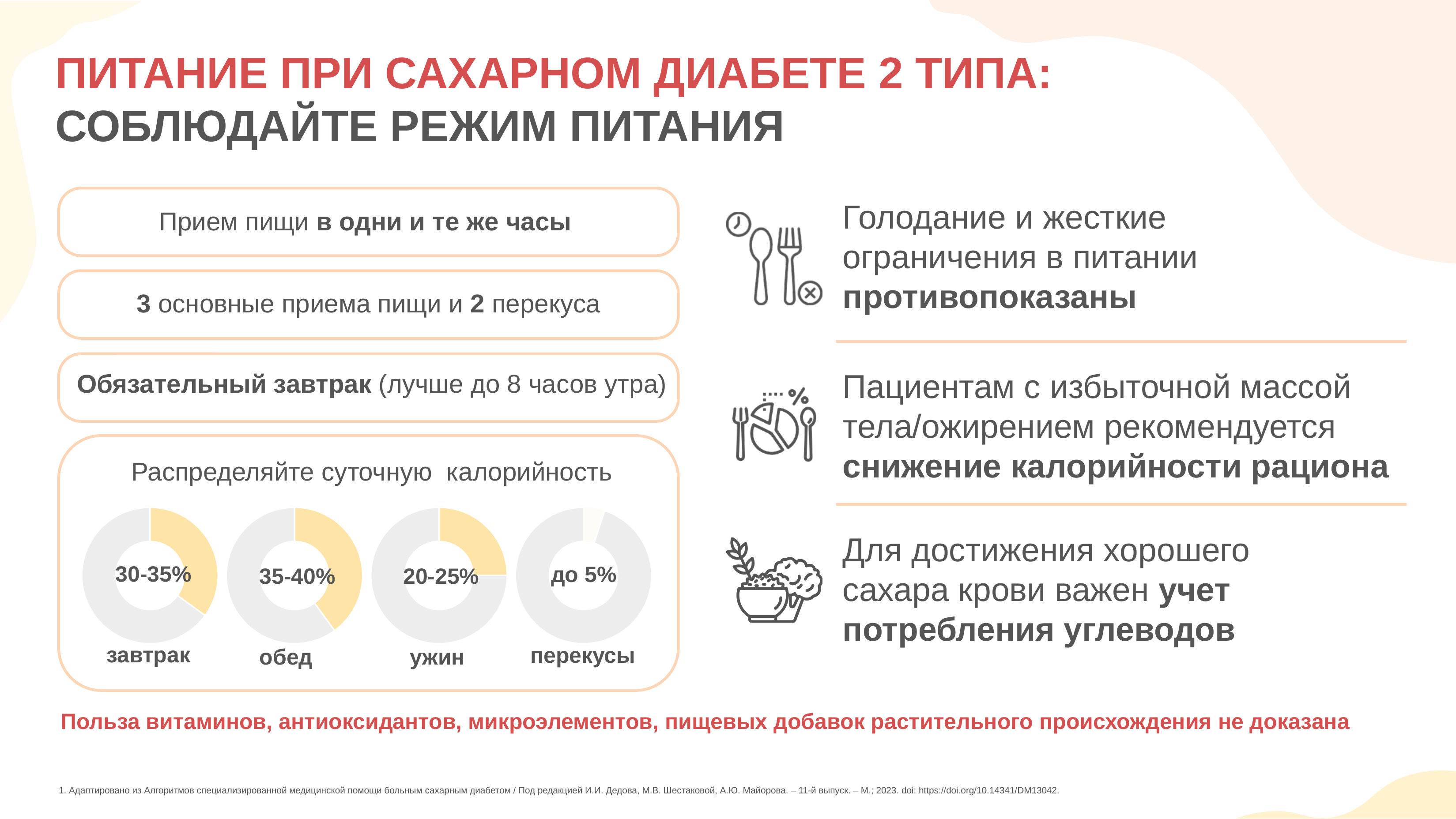
Which has a larger share of daily calories, обед or перекусы? обед In the daily calorie distribution charts, what share is shown for завтрак (breakfast)? 30-35% What kind of chart is used to show the daily calorie distribution? Donut (pie) chart Which has a larger share of daily calories, завтрак or ужин? завтрак What colour is used to highlight the meal's share in each donut chart? Yellow In the daily calorie distribution charts, what share is shown for ужин (dinner)? 20-25% In the daily calorie distribution charts, what share is shown for обед (lunch)? 35-40% What is the heading above the four donut charts? Распределяйте суточную калорийность How many donut charts are shown in the calorie distribution block? 4 Which meal is assigned the largest share of daily calories in the donut charts? обед Which category is assigned the smallest share of daily calories in the donut charts? перекусы In the daily calorie distribution charts, what share is shown for перекусы (snacks)? до 5%